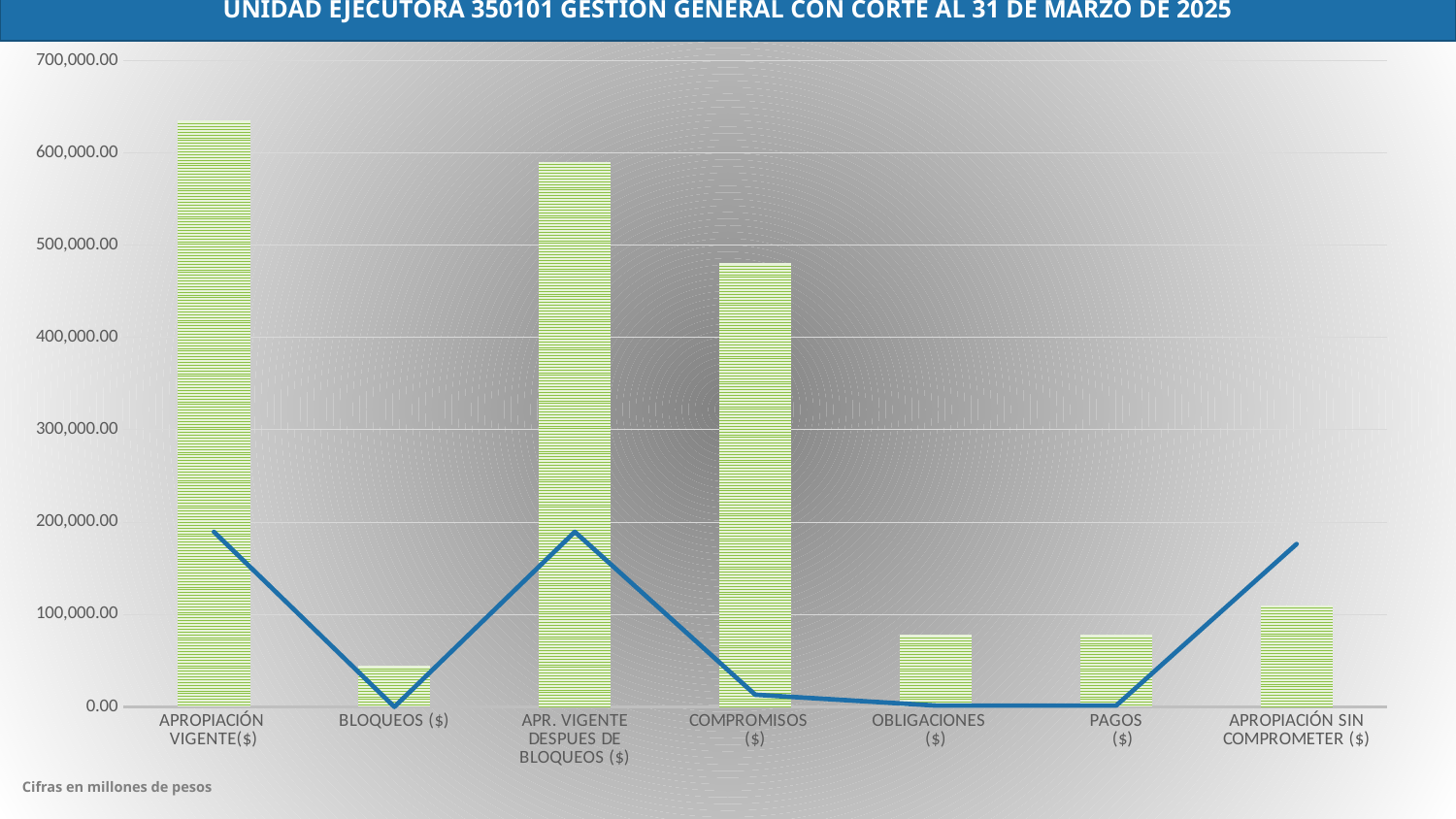
Is the bar value for COMPROMISOS ($) greater or less than 500,000.00? less According to the note below the chart, in what units are the figures expressed? Millones de pesos Which bar is taller, COMPROMISOS ($) or APR. VIGENTE DESPUES DE BLOQUEOS ($)? APR. VIGENTE DESPUES DE BLOQUEOS ($) What kind of chart is shown on the slide? A combined bar and line chart Is the bar value for BLOQUEOS ($) greater or less than 100,000.00? less Is the bar value for APR. VIGENTE DESPUES DE BLOQUEOS ($) greater or less than 500,000.00? greater How many categories are shown on the x axis? 7 Which bar is taller, OBLIGACIONES ($) or APROPIACIÓN SIN COMPROMETER ($)? APROPIACIÓN SIN COMPROMETER ($) Which category has the tallest bar? APROPIACIÓN VIGENTE($) Which category has the shortest bar? BLOQUEOS ($)